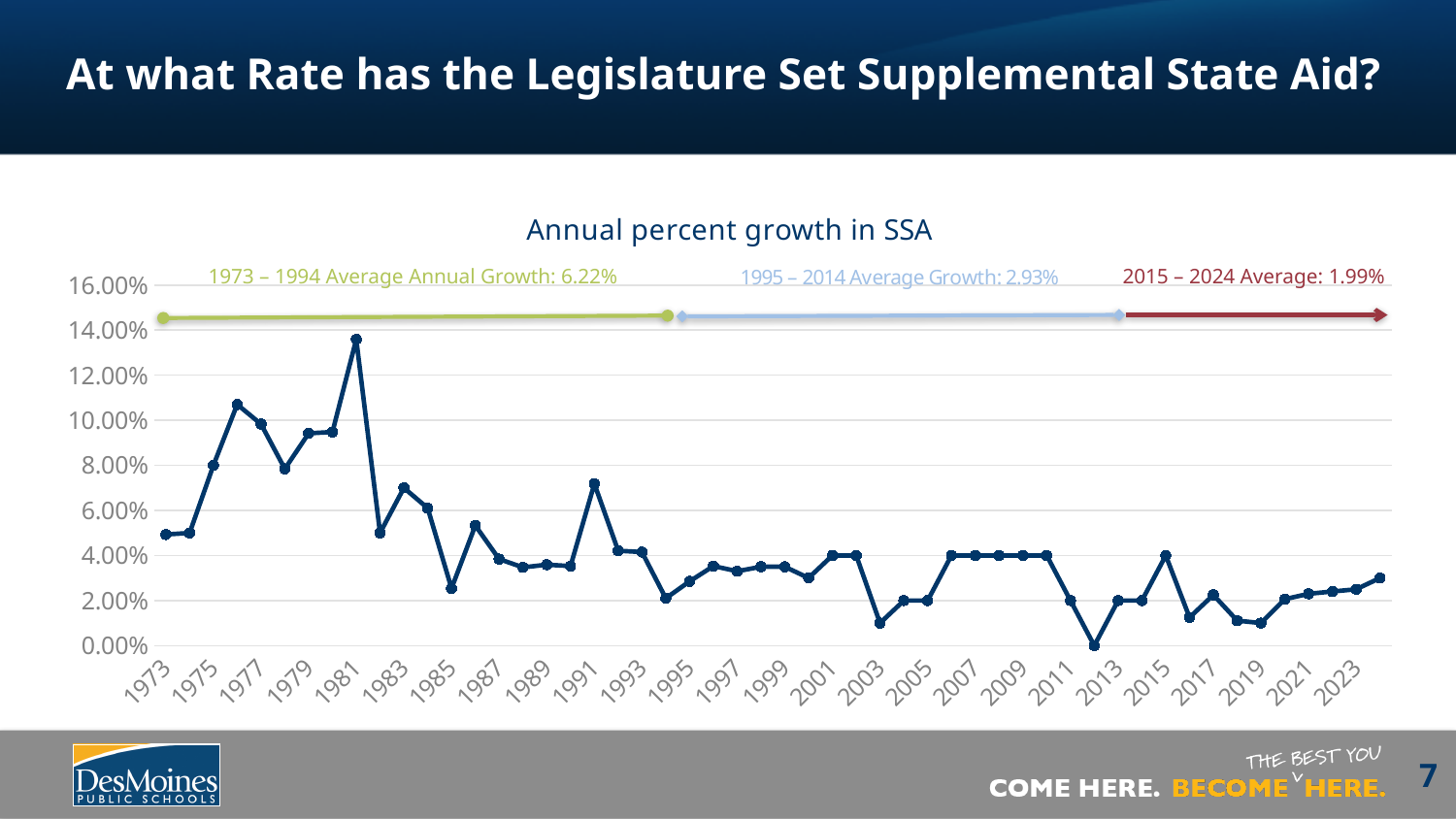
What is the average shown for 2015 – 2024? 1.99% Is the value for 1991 greater or less than 6.00%? greater What is the average annual growth shown for 1973 – 1994? 6.22% Which year has the larger value, 1981 or 1976? 1981 Is the value for 1981 greater or less than 12.00%? greater What is the title of the chart? Annual percent growth in SSA Is the value for 2003 greater or less than 2.00%? less In which year does the annual percent growth in SSA reach its highest point? 1981 Which year has the larger value, 1991 or 1995? 1991 In which year does the annual percent growth in SSA reach its lowest point? 2012 Overall, do the values rise or fall from 1973 to 2023? fall What kind of chart is shown on the slide? line chart